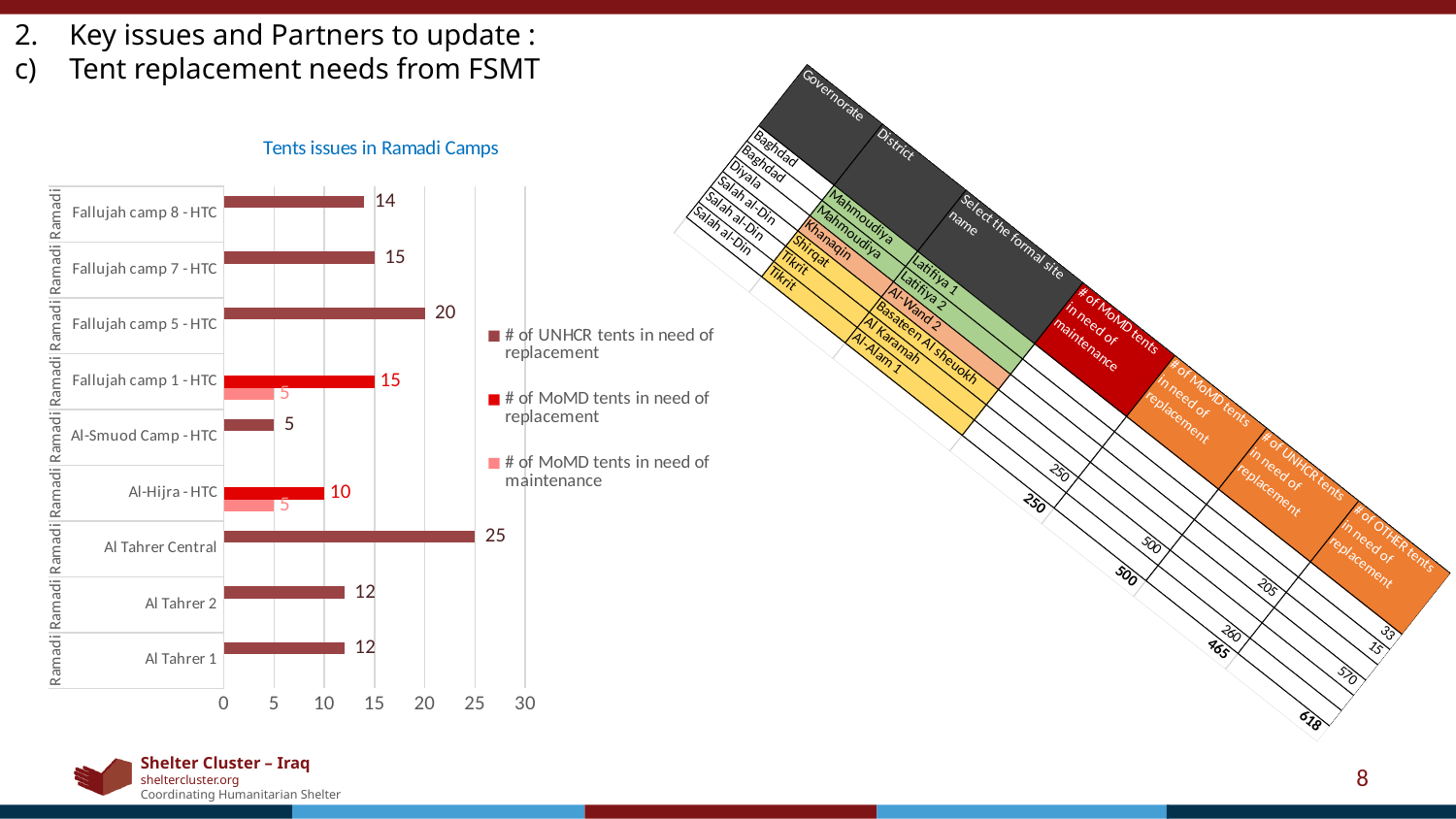
In the 'Tents issues in Ramadi Camps' chart, what is the difference between the UNHCR tents in need of replacement at Al Tahrer Central and at Al Tahrer 1? 13 In the 'Tents issues in Ramadi Camps' chart, which camp has the highest number of UNHCR tents in need of replacement? Al Tahrer Central In the 'Tents issues in Ramadi Camps' chart, how many camps are listed on the vertical axis? 9 What is the title of the bar chart on the left of the slide? Tents issues in Ramadi Camps In the 'Tents issues in Ramadi Camps' chart, which has more MoMD tents in need of replacement: Fallujah camp 1 - HTC or Al-Hijra - HTC? Fallujah camp 1 - HTC In the 'Tents issues in Ramadi Camps' chart, what is the number of UNHCR tents in need of replacement for Al Tahrer Central? 25 In the 'Tents issues in Ramadi Camps' chart, what is the number of MoMD tents in need of maintenance for Al-Hijra - HTC? 5 In the 'Tents issues in Ramadi Camps' chart, what is the number of UNHCR tents in need of replacement for Fallujah camp 5 - HTC? 20 What kind of chart is 'Tents issues in Ramadi Camps'? bar chart In the 'Tents issues in Ramadi Camps' chart, how many series does the legend list? 3 In the 'Tents issues in Ramadi Camps' chart, is the value for Fallujah camp 8 - HTC greater or less than 10? greater In the 'Tents issues in Ramadi Camps' chart, which camp has the lowest number of UNHCR tents in need of replacement? Al-Smuod Camp - HTC